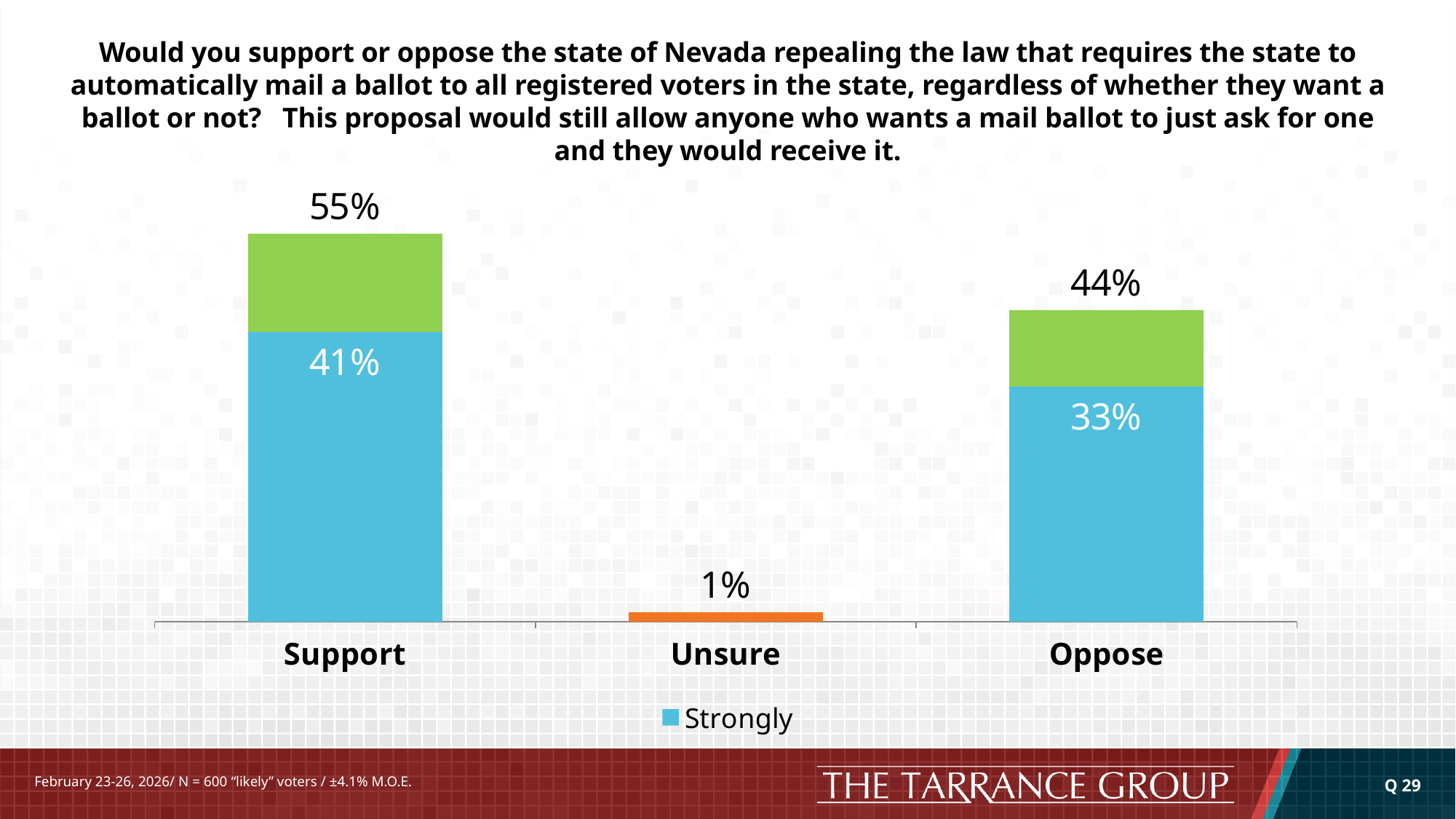
How many categories are shown on the x axis? 3 What percentage strongly oppose? 33% Which category has the highest total value? Support What percentage is shown for Unsure? 1% What percentage strongly support? 41% What kind of chart is shown on the slide? Bar chart What is the total percentage shown for Support? 55% What is the difference between the strongly support and strongly oppose percentages? 8% What is the difference between the total Support and total Oppose percentages? 11% Which category has the lowest value? Unsure Which is larger, the strongly support value or the strongly oppose value? Strongly support What is the total percentage shown for Oppose? 44%